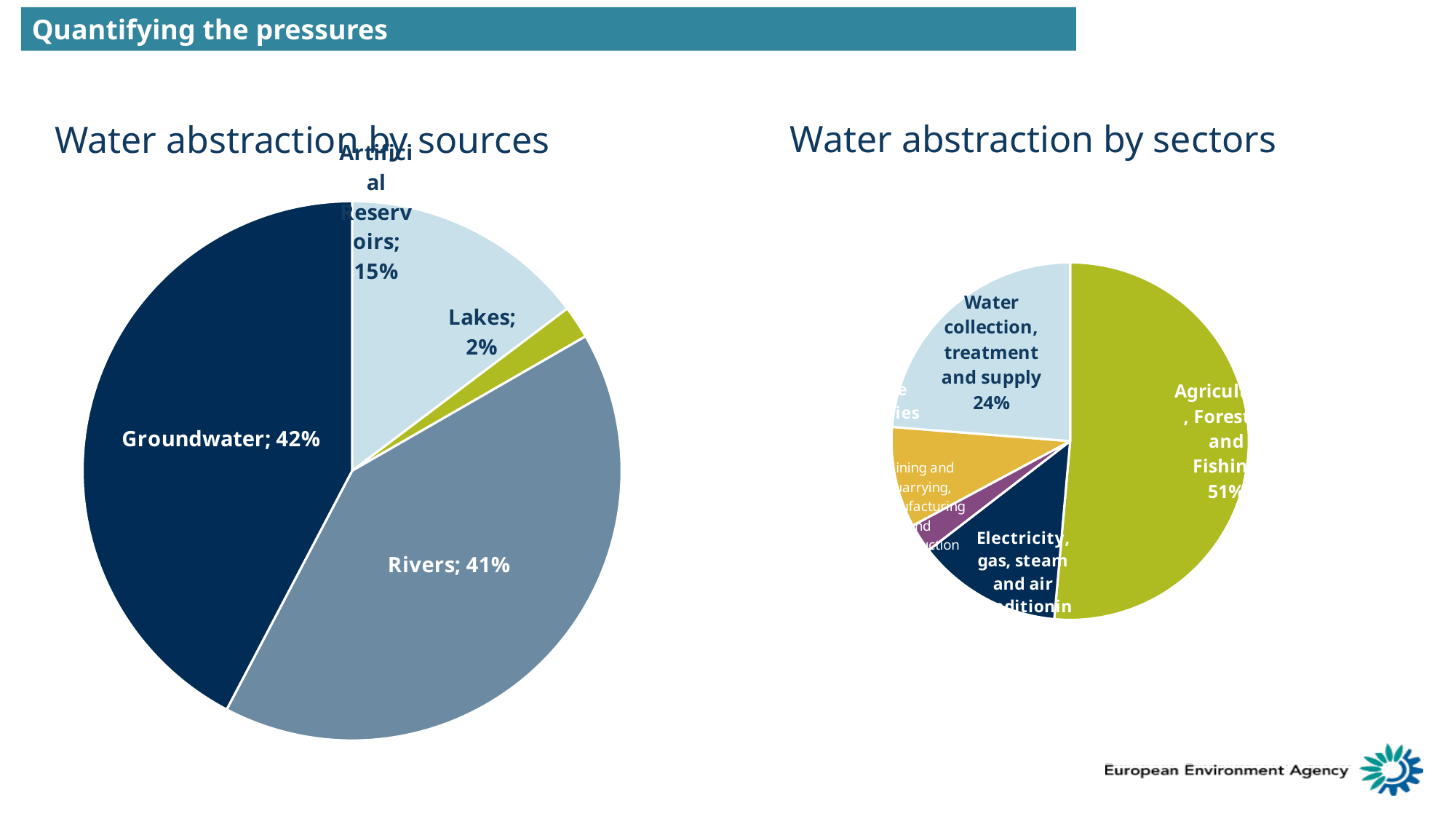
In the 'Water abstraction by sectors' pie chart, what share does Agriculture, Forestry and Fishing have? 51% In the 'Water abstraction by sources' pie chart, what share do Artificial Reservoirs have? 15% In the 'Water abstraction by sources' pie chart, what is the difference between the Groundwater and Rivers shares? 1% In the 'Water abstraction by sectors' pie chart, what share does Water collection, treatment and supply have? 24% In the 'Water abstraction by sectors' pie chart, which sector has the largest share? Agriculture, Forestry and Fishing In the 'Water abstraction by sources' pie chart, which source has the smallest share? Lakes In the 'Water abstraction by sources' pie chart, what share does Groundwater have? 42% In the 'Water abstraction by sources' pie chart, what share does Rivers have? 41% In the 'Water abstraction by sectors' pie chart, how many slices are there? 5 What type of chart is 'Water abstraction by sources'? Pie chart In the 'Water abstraction by sources' pie chart, how many slices are there? 4 In the 'Water abstraction by sources' pie chart, which source has the largest share? Groundwater